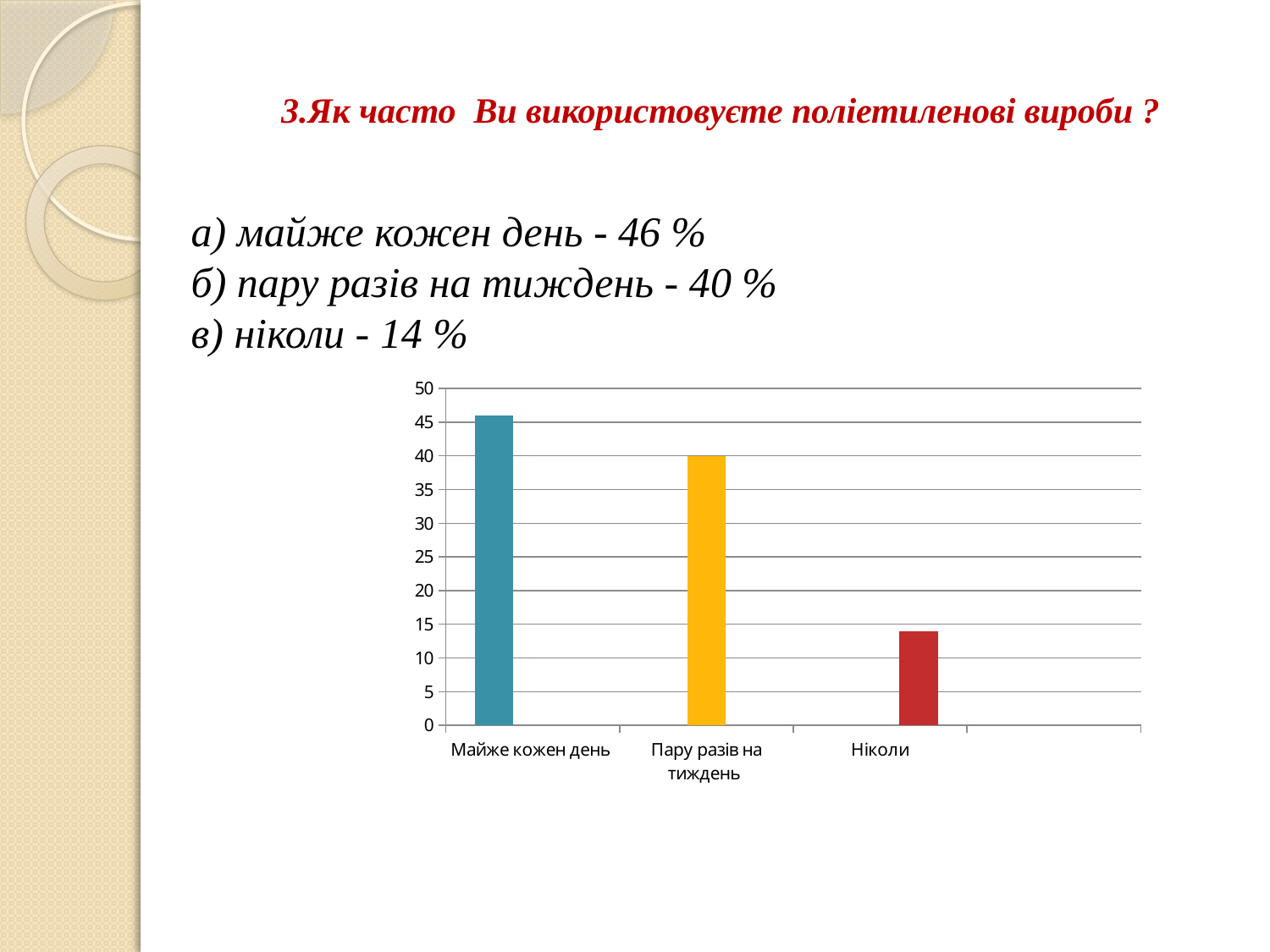
What is the value for "Ніколи"? 14 % What is the difference between the values for "Майже кожен день" and "Пару разів на тиждень"? 6 % Which category has the lowest value? Ніколи Which category has the highest value? Майже кожен день What kind of chart is shown on the slide? bar chart Is the value for "Ніколи" greater or less than 15? less What colour is the bar for "Пару разів на тиждень"? yellow What is the difference between the values for "Пару разів на тиждень" and "Ніколи"? 26 % How many categories are plotted in the chart? 3 What is the value for "Майже кожен день"? 46 % What is the value for "Пару разів на тиждень"? 40 % Which is larger, the value for "Пару разів на тиждень" or the value for "Ніколи"? Пару разів на тиждень